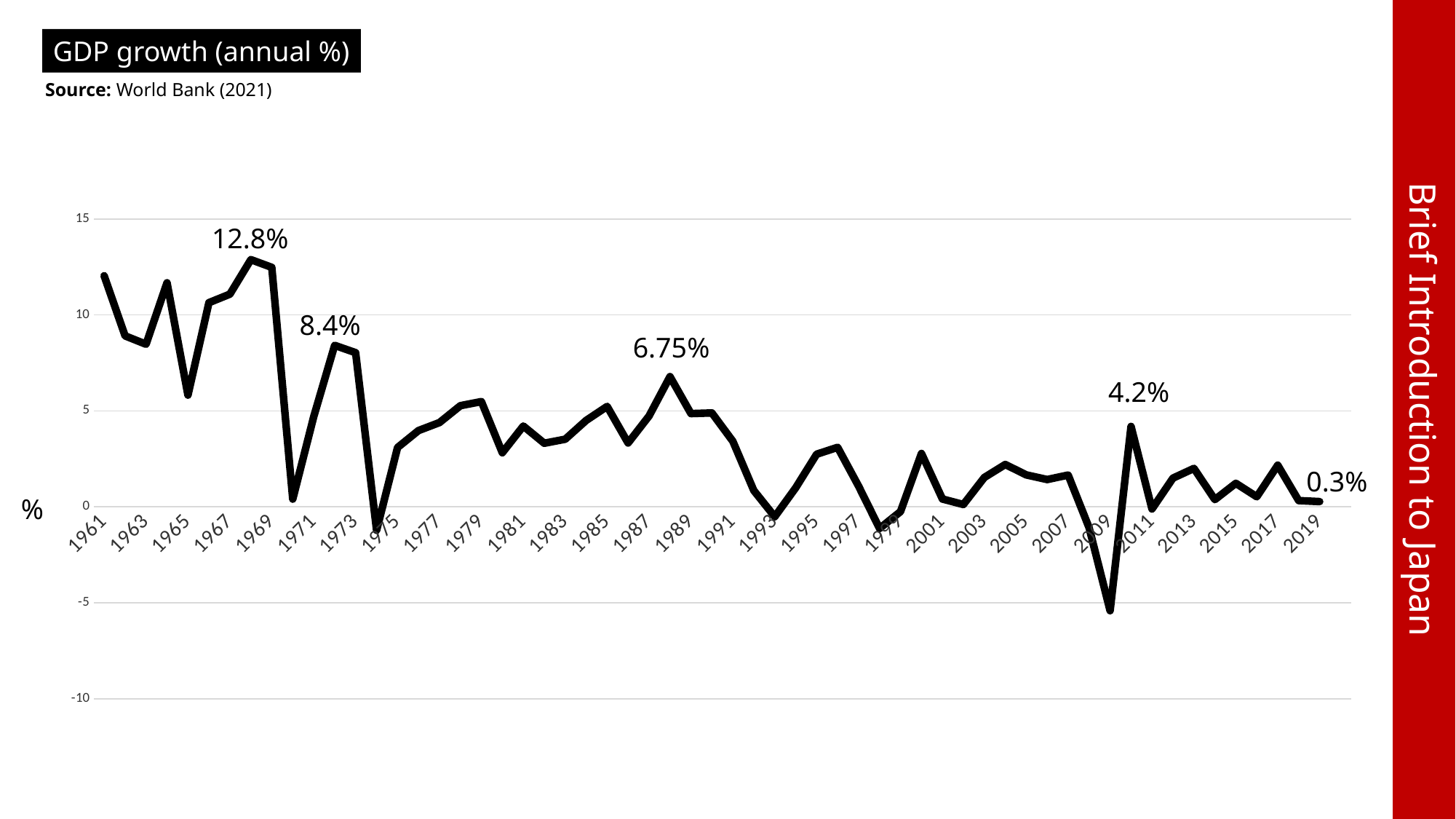
What value is labelled at the peak in the late 1980s? 6.75% Is the value for 1961 greater or less than 10? greater Is the value for 1974 greater or less than 0? less What is the highest value labelled on the chart? 12.8% What kind of chart is shown on the slide? line chart What is the title of the chart? GDP growth (annual %) What value is labelled at the peak in 2010? 4.2% Overall, do the GDP growth values rise or fall from 1961 to 2019? fall What is the difference between the labelled values 12.8% and 0.3%? 12.5 percentage points What source is cited for the chart data? World Bank (2021) What is the value labelled at the end of the series, in 2019? 0.3% Which labelled value is larger, 8.4% or 6.75%? 8.4%